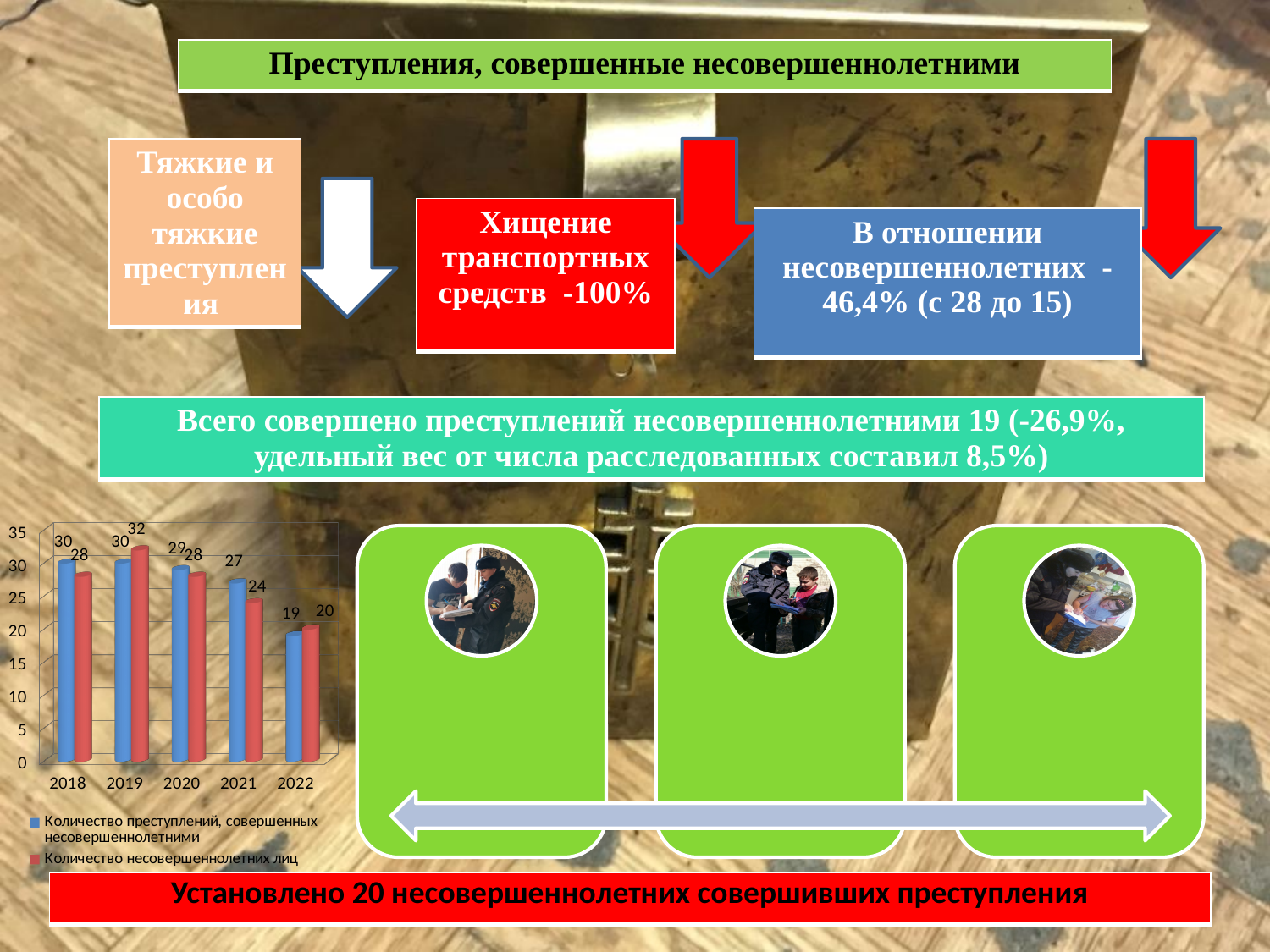
What is the value of 'Количество несовершеннолетних лиц' for 2021? 24 In 2020, which is larger: 'Количество преступлений, совершенных несовершеннолетними' or 'Количество несовершеннолетних лиц'? Количество преступлений, совершенных несовершеннолетними How many series does the chart legend list? 2 What is the value of 'Количество преступлений, совершенных несовершеннолетними' for 2022? 19 In which year is 'Количество несовершеннолетних лиц' highest? 2019 What is the difference between 'Количество преступлений, совершенных несовершеннолетними' in 2018 and in 2022? 11 What colour are the bars for 'Количество несовершеннолетних лиц'? red How many years are shown on the x axis of the chart? 5 Does 'Количество преступлений, совершенных несовершеннолетними' generally rise or fall from 2018 to 2022? fall In which year is 'Количество преступлений, совершенных несовершеннолетними' lowest? 2022 What is the value of 'Количество несовершеннолетних лиц' for 2019? 32 What type of chart is shown on the slide? bar chart